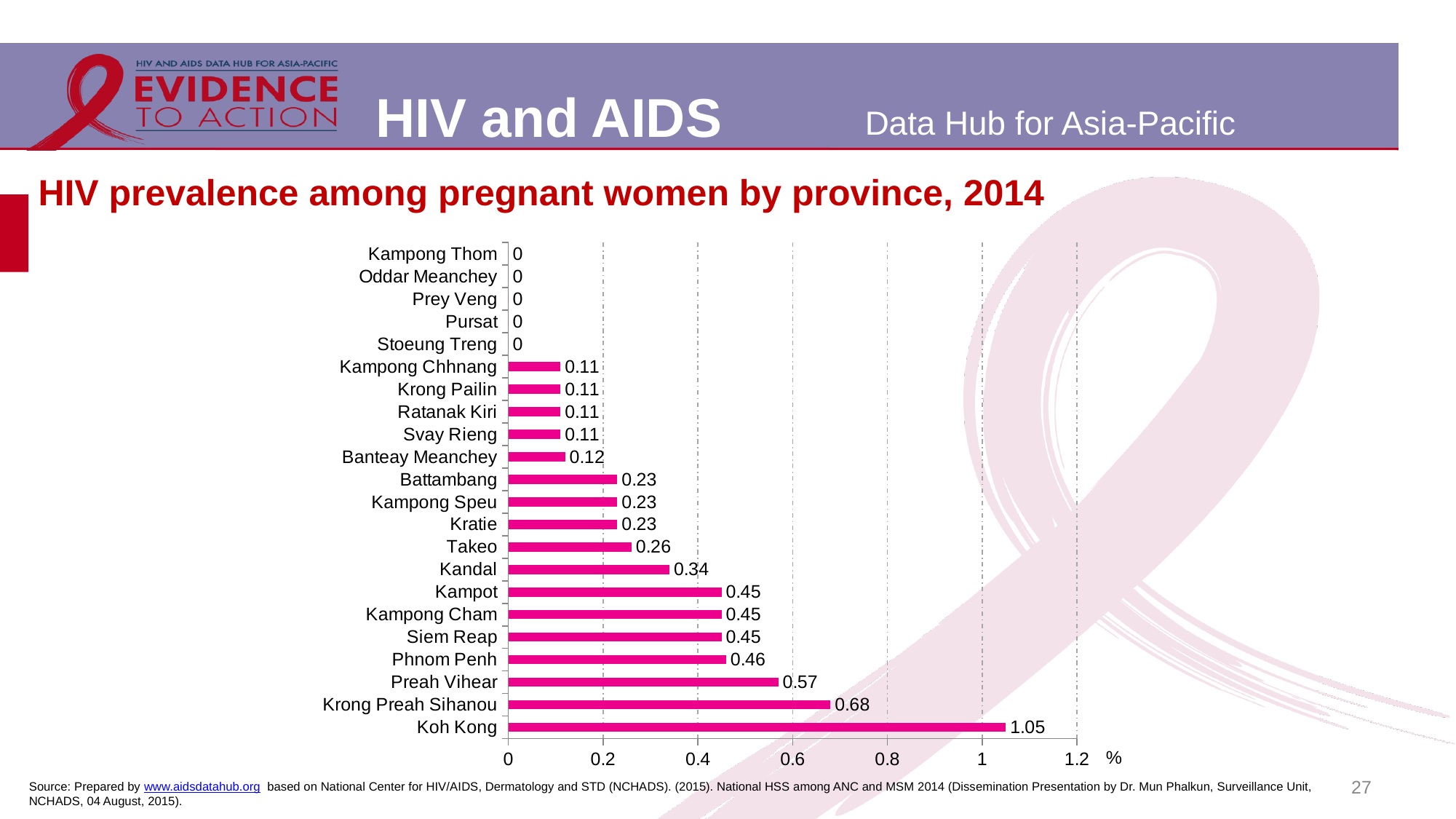
Which province has the highest HIV prevalence among pregnant women? Koh Kong Is the value for Krong Preah Sihanou greater or less than 0.6? greater What is the HIV prevalence among pregnant women in Koh Kong? 1.05 What is the difference between the values for Koh Kong and Krong Preah Sihanou? 0.37 What is the difference between the values for Preah Vihear and Takeo? 0.31 Which is larger, the value for Kampot or the value for Banteay Meanchey? Kampot What is the value for Kandal? 0.34 How many provinces have a value of 0? 5 How many provinces are shown in the chart? 22 What kind of chart is shown on the slide? Bar chart What value is shown for Phnom Penh? 0.46 What is the title of the chart? HIV prevalence among pregnant women by province, 2014